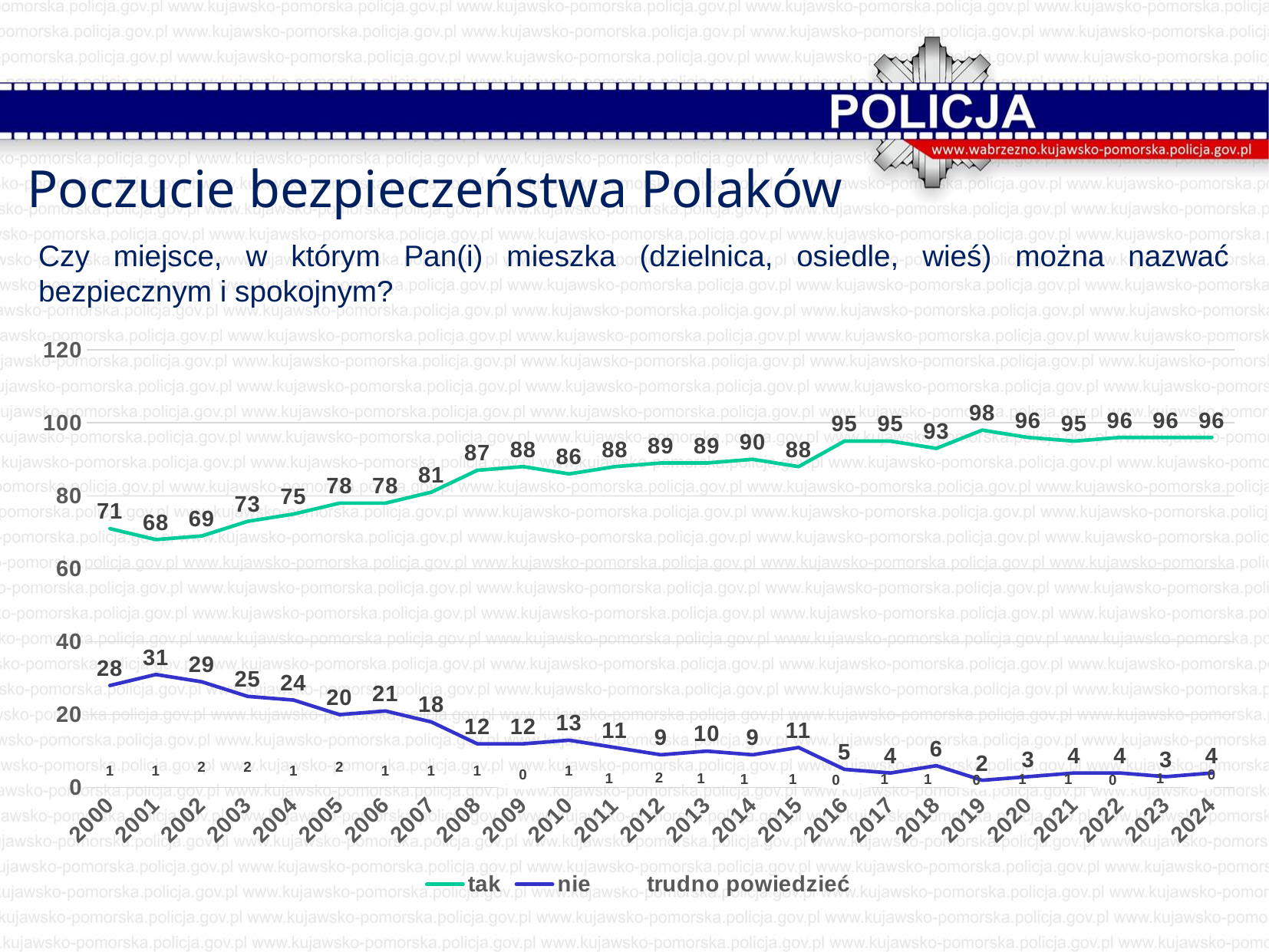
Which is larger: the "nie" value in 2005 or in 2006? 2006 What is the value of the "nie" series in 2008? 12 In which year does the "tak" series reach its highest value? 2019 What is the value of the "tak" series in 2019? 98 How many years are shown on the x axis? 25 What is the difference between the "tak" and "nie" values in 2000? 43 In which year does the "nie" series reach its highest value? 2001 By how much did the "tak" value increase from 2000 to 2024? 25 What kind of chart is shown on the slide? line chart Does the "nie" series generally rise or fall from 2000 to 2024? fall In which year is the "tak" series at its lowest value? 2001 How many series does the legend list? 3